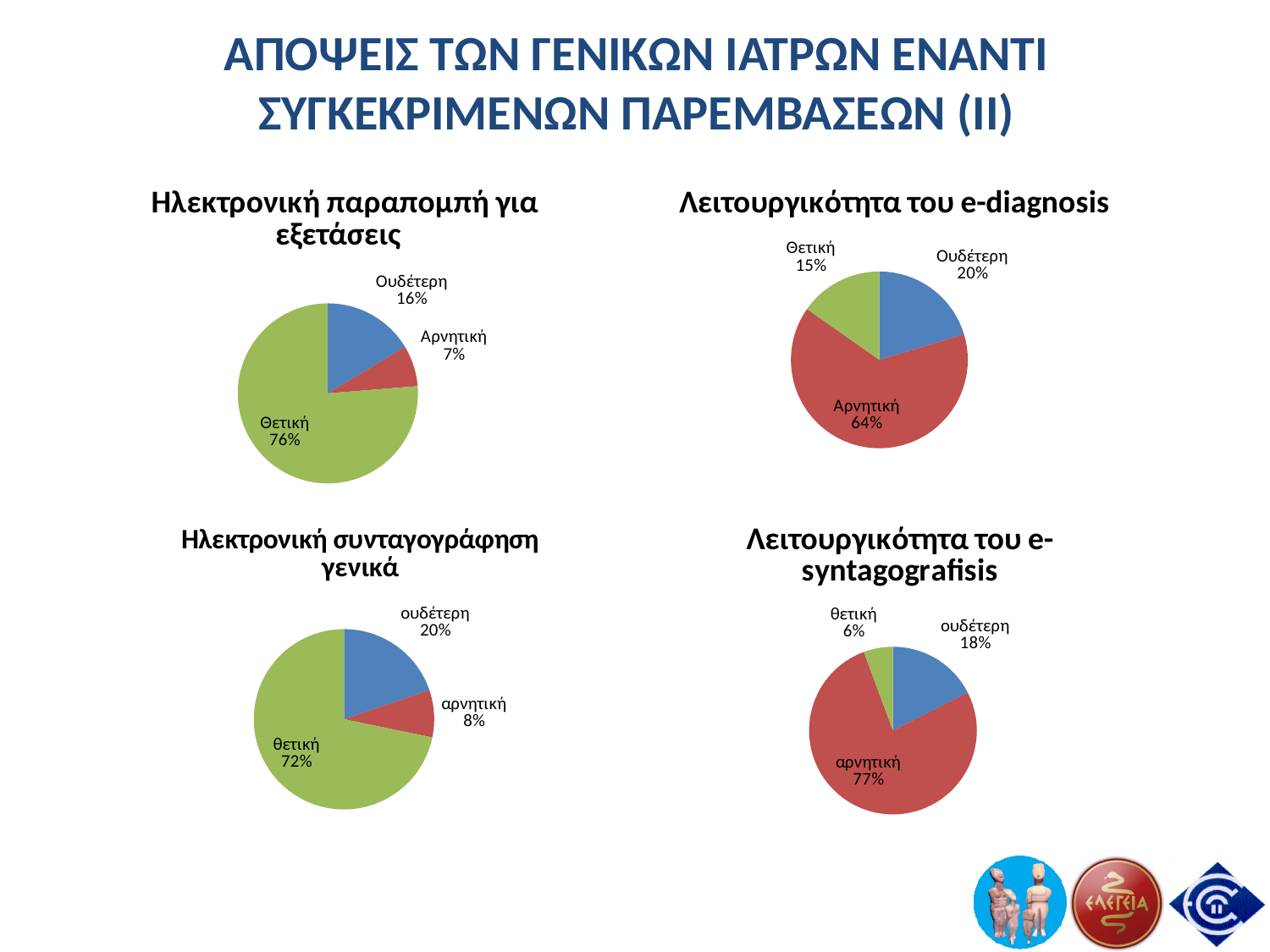
In the 'Λειτουργικότητα του e-syntagografisis' chart, what is the difference between the ουδέτερη and θετική shares? 12% In the 'Ηλεκτρονική συνταγογράφηση γενικά' chart, which category has the largest slice? θετική What type of chart is 'Ηλεκτρονική συνταγογράφηση γενικά'? Pie chart In the 'Ηλεκτρονική παραπομπή για εξετάσεις' chart, what share is Αρνητική? 7% In the 'Ηλεκτρονική συνταγογράφηση γενικά' chart, what share is ουδέτερη? 20% In the 'Ηλεκτρονική παραπομπή για εξετάσεις' chart, what share is Θετική? 76% In the 'Λειτουργικότητα του e-syntagografisis' chart, what share is αρνητική? 77% In the 'Λειτουργικότητα του e-diagnosis' chart, which category has the smallest slice? Θετική In the 'Λειτουργικότητα του e-diagnosis' chart, what share is Αρνητική? 64% In the 'Ηλεκτρονική παραπομπή για εξετάσεις' chart, which is larger, Ουδέτερη or Αρνητική? Ουδέτερη In the 'Λειτουργικότητα του e-syntagografisis' chart, what share is θετική? 6% How many slices does the 'Λειτουργικότητα του e-diagnosis' chart have? 3